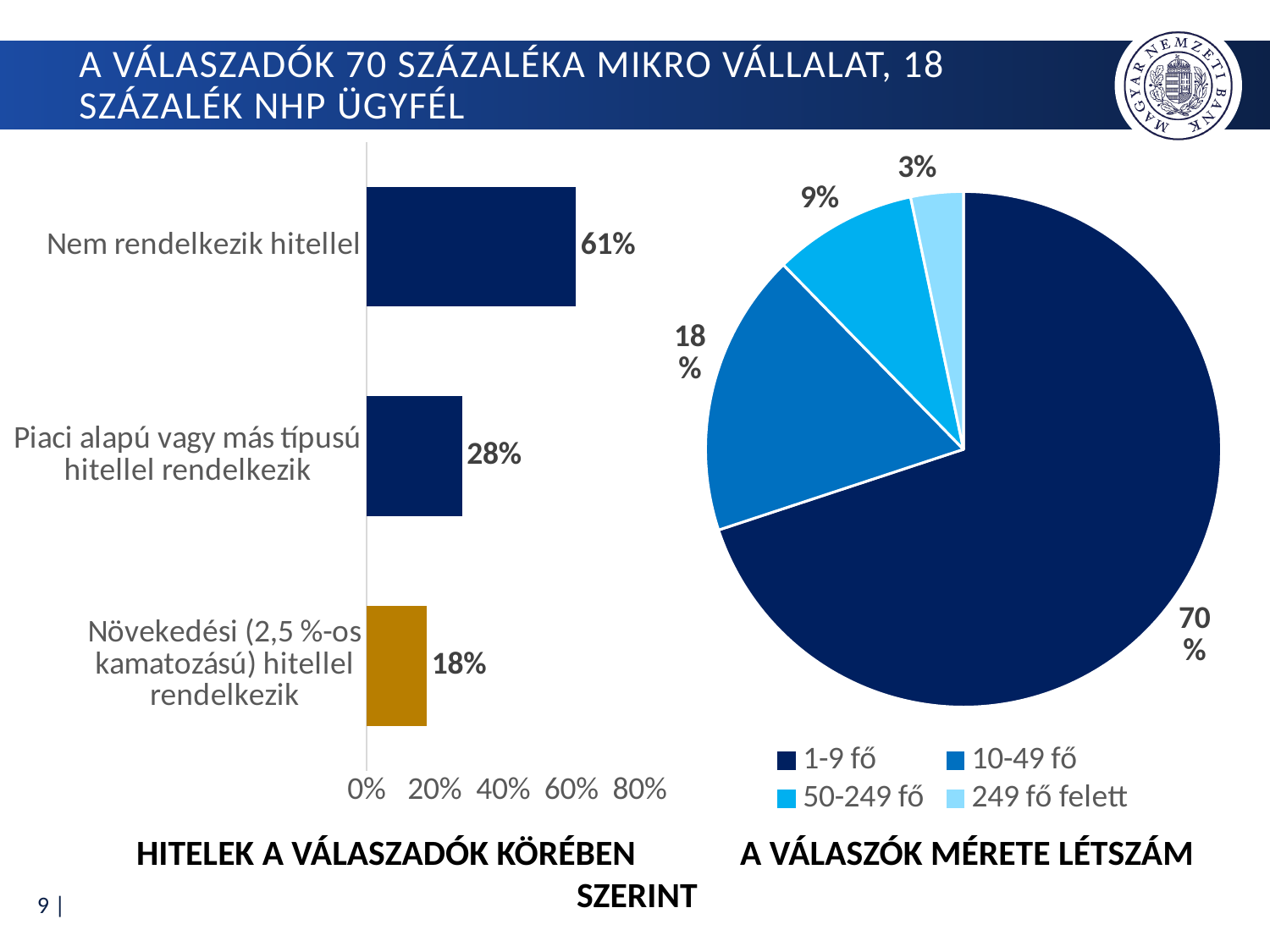
In the pie chart on the right, what share do companies with '1-9 fő' have? 70% In the pie chart on the right, what is the value for '50-249 fő'? 9% In the bar chart on the left, what is the difference between 'Nem rendelkezik hitellel' and 'Piaci alapú vagy más típusú hitellel rendelkezik'? 33% In the bar chart on the left, which category has the highest value? Nem rendelkezik hitellel In the bar chart on the left, how many categories are shown? 3 In the bar chart on the left, what is the value for 'Nem rendelkezik hitellel'? 61% In the pie chart on the right, which category has the smallest slice? 249 fő felett In the pie chart on the right, which is larger: '10-49 fő' or '50-249 fő'? 10-49 fő In the bar chart on the left, what is the value for 'Piaci alapú vagy más típusú hitellel rendelkezik'? 28% What kind of chart is the chart on the left of the slide? Bar chart How many entries does the legend of the pie chart on the right list? 4 In the bar chart on the left, what is the value for 'Növekedési (2,5 %-os kamatozású) hitellel rendelkezik'? 18%